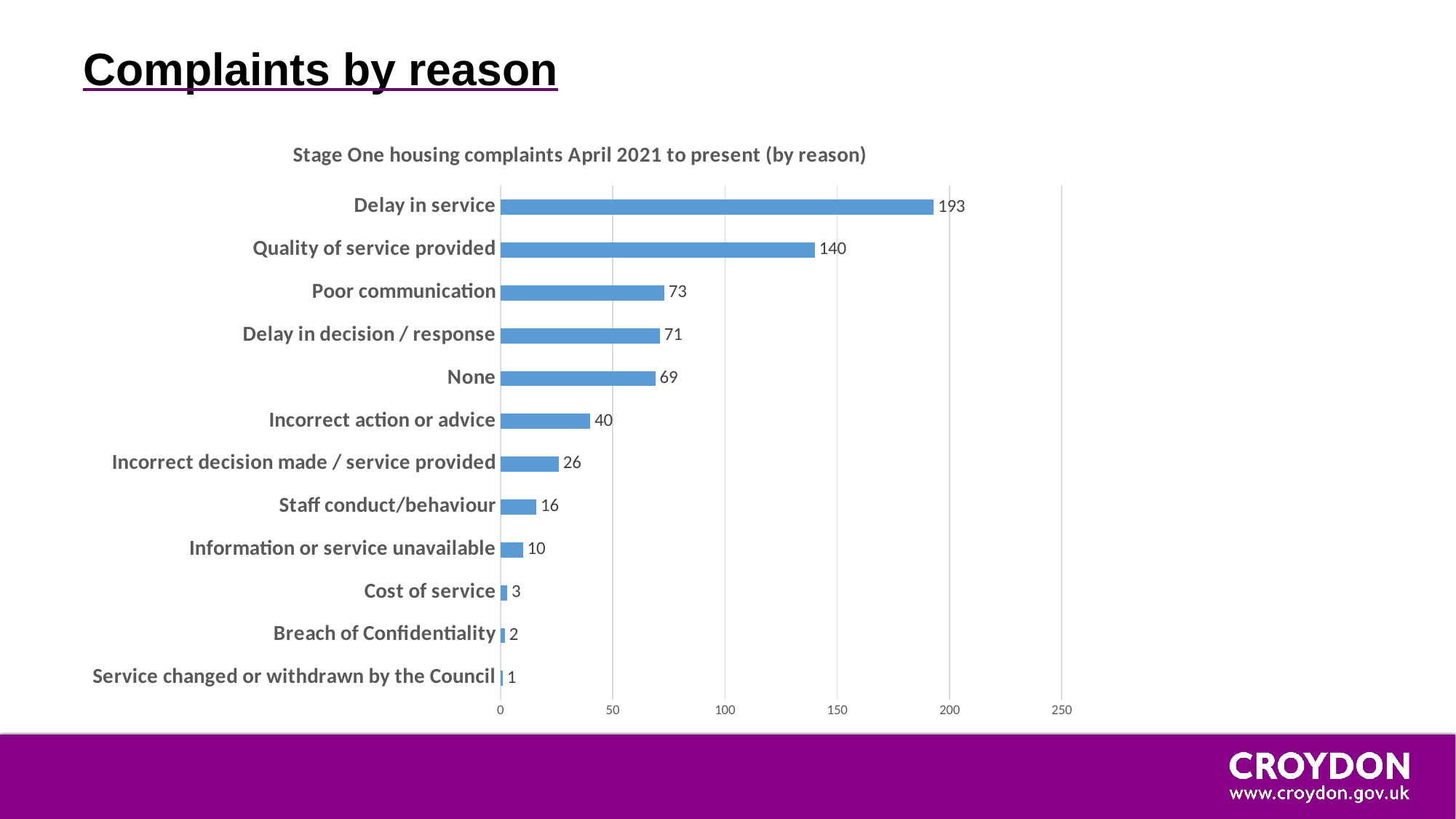
Which reason has the lowest number of complaints? Service changed or withdrawn by the Council Which reason has the highest number of complaints? Delay in service Which is larger, Incorrect decision made / service provided or Information or service unavailable? Incorrect decision made / service provided What is the difference between Poor communication and Incorrect action or advice? 33 What type of chart is shown on the slide? Bar chart What is the value for Incorrect action or advice? 40 Is the value for Quality of service provided greater or less than 100? greater What is the value for Staff conduct/behaviour? 16 What is the value for Quality of service provided? 140 What is the difference between Delay in service and Quality of service provided? 53 What is the value for Delay in service? 193 How many reasons (categories) are shown in the chart? 12